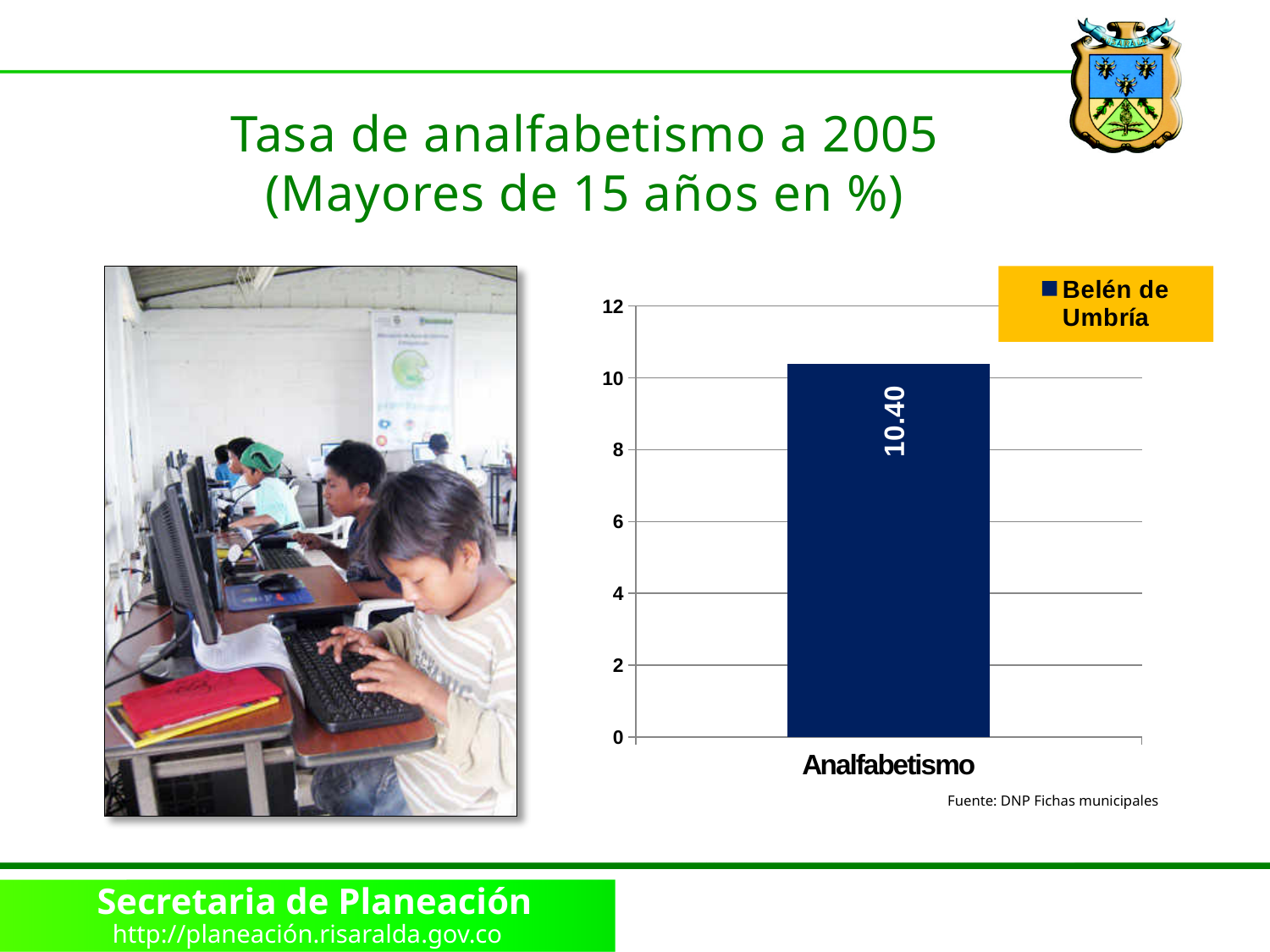
What is the maximum value shown on the y axis of the chart? 12 What kind of chart is shown on the slide? bar chart How many bars are plotted in the chart? 1 What series name appears in the chart legend? Belén de Umbría What is the value of the Analfabetismo bar for Belén de Umbría? 10.40 Is the value for Analfabetismo greater or less than 10? greater How many series does the legend list? 1 Is the value for Analfabetismo greater or less than 12? less What is the category label shown on the x axis of the chart? Analfabetismo